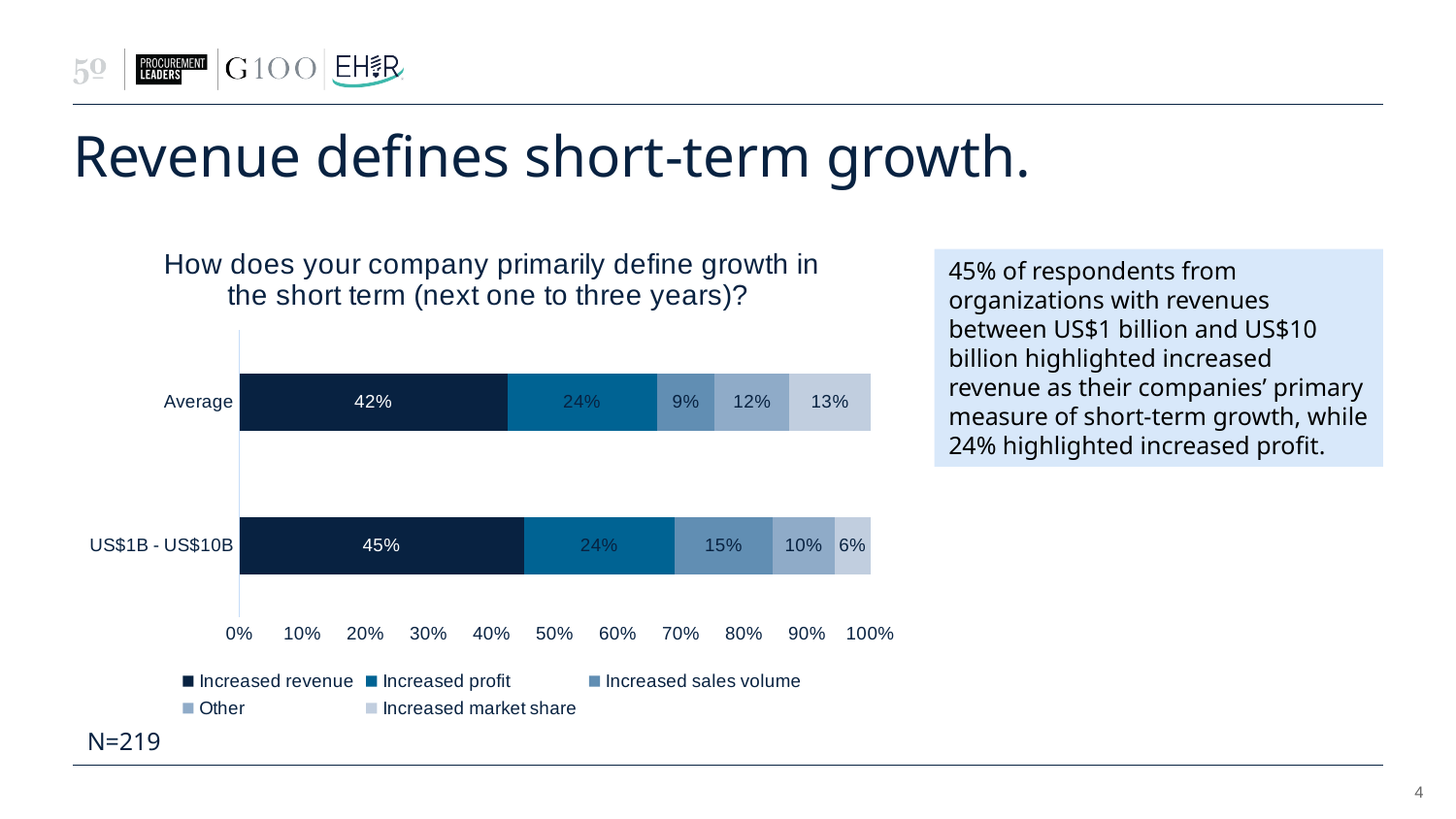
What is the difference between the Increased sales volume values for US$1B - US$10B and Average? 6% What is the value for Increased revenue in the US$1B - US$10B bar? 45% What is the value for Increased profit in the Average bar? 24% What type of chart is shown on the slide? Stacked bar chart What is the value for Increased revenue in the Average bar? 42% Which is larger: Increased revenue for Average or Increased revenue for US$1B - US$10B? US$1B - US$10B Which segment is the smallest in the US$1B - US$10B bar? Increased market share What is the sample size (N) stated below the chart? N=219 How many series does the legend list? 5 How many categories (bars) are plotted in the chart? 2 What is the value for Increased sales volume in the US$1B - US$10B bar? 15% Which segment is the largest in the Average bar? Increased revenue